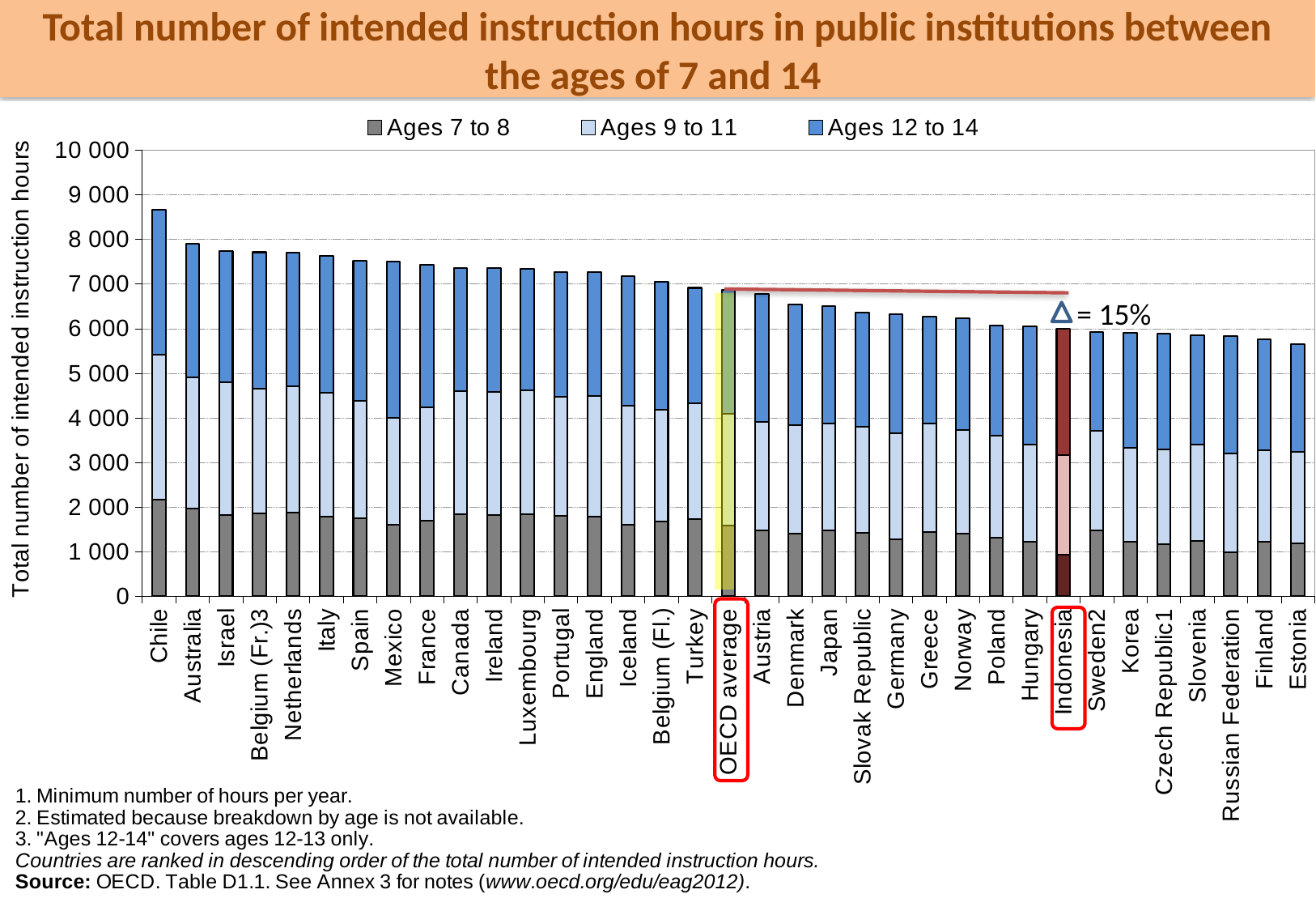
Is the total for Austria greater or less than 7 000? less Which has a larger total of intended instruction hours, Chile or Estonia? Chile Is the total for Australia greater or less than 7 000? greater Is the total for Estonia greater or less than 6 000? less How many series does the legend list? 3 How many categories (countries and averages) are shown on the x axis? 35 Which country has the highest total number of intended instruction hours? Chile Which country has the lowest total number of intended instruction hours? Estonia Do the total bar heights rise or fall from left to right along the x axis? Fall What kind of chart is shown on the slide? Stacked bar chart What percentage difference is annotated between the OECD average and Indonesia? 15%